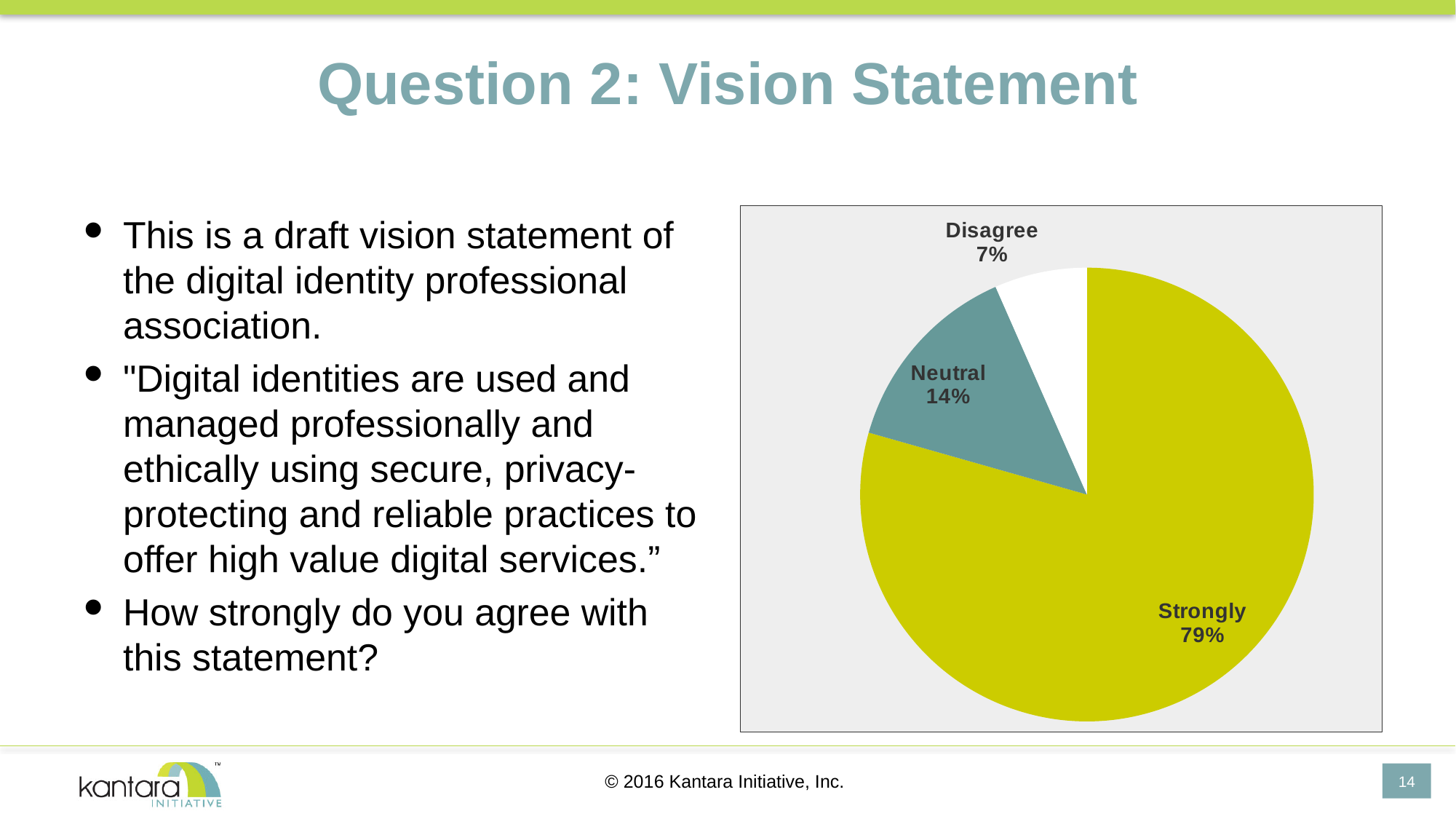
What share of the pie does the Strongly slice represent? 79% What share of the pie does the Disagree slice represent? 7% What colour is the Neutral slice? Teal How many slices does the pie chart have? 3 Which slice is larger, Neutral or Disagree? Neutral What kind of chart is shown on the slide? Pie chart What is the difference in percentage points between the Neutral and Disagree slices? 7 Which category has the smallest slice of the pie? Disagree Which category has the largest slice of the pie? Strongly What colour is the Strongly slice? Yellow-green What share of the pie does the Neutral slice represent? 14% What is the difference in percentage points between the Strongly and Neutral slices? 65